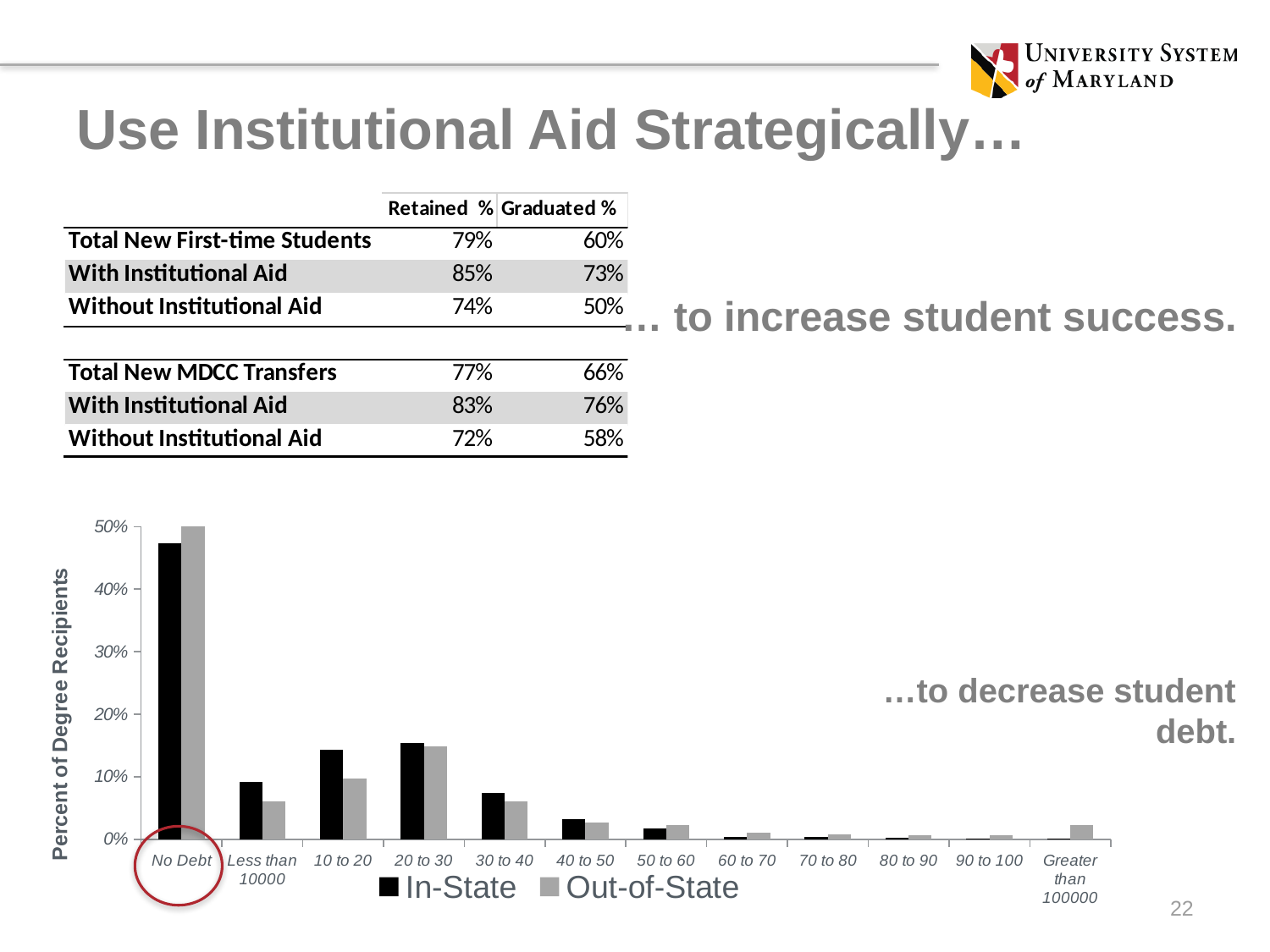
Is the In-State value for No Debt greater or less than 40%? greater Which category has the highest In-State bar in the chart? No Debt What kind of chart is shown at the bottom of the slide? bar chart Is the In-State value for 10 to 20 greater or less than 10%? greater What are the two series named in the chart legend? In-State and Out-of-State Is the Out-of-State value for 30 to 40 greater or less than 10%? less For the 10 to 20 category, which series has the larger bar, In-State or Out-of-State? In-State How many debt categories are shown along the x axis of the chart? 12 How many series does the chart legend list? 2 Which category has the highest Out-of-State bar in the chart? No Debt What is the label on the y axis of the chart? Percent of Degree Recipients